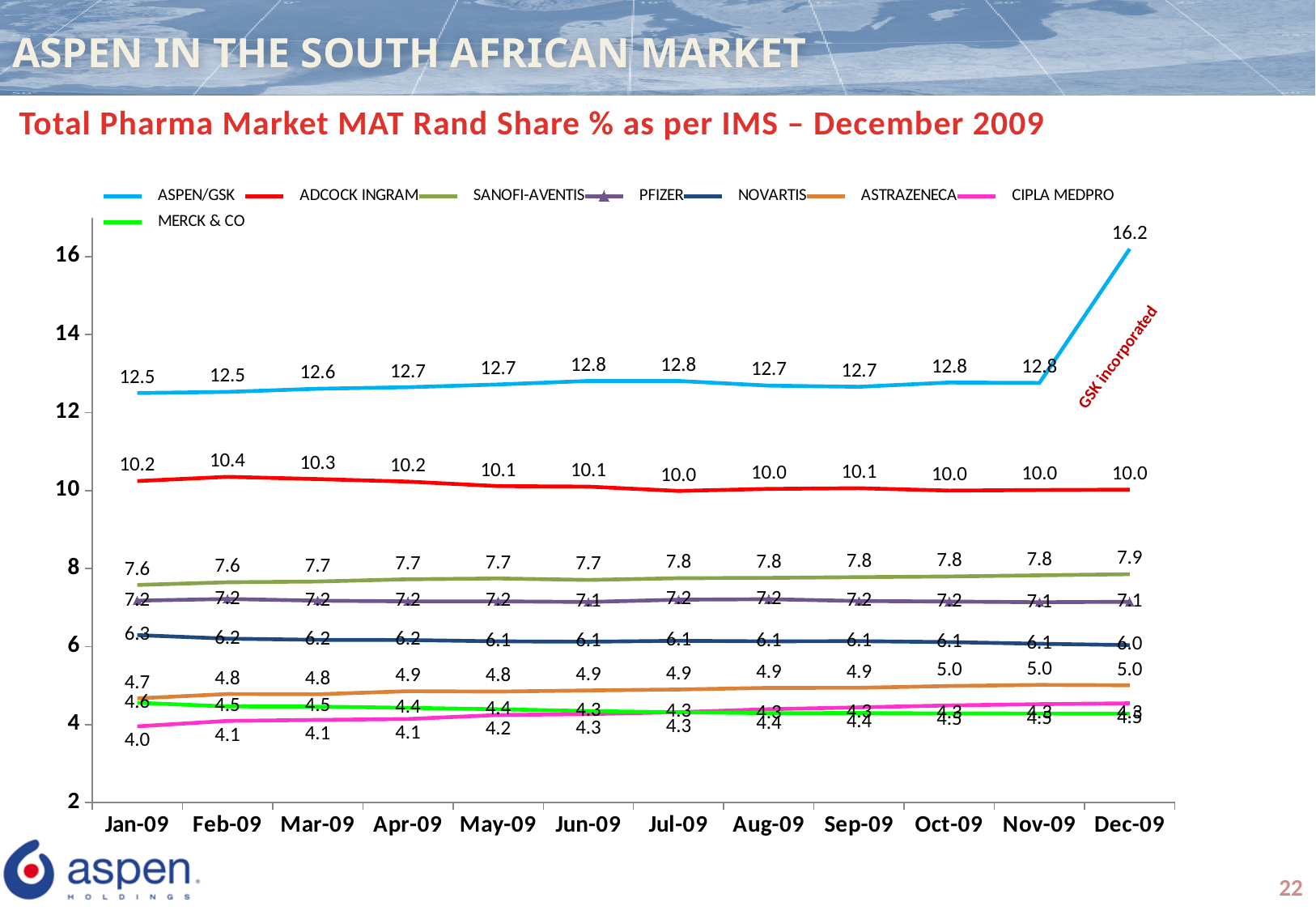
By how much did the ASPEN/GSK value increase from Nov-09 to Dec-09? 3.4 What is the ASPEN/GSK value for Dec-09? 16.2 How many series does the legend list? 8 What is the NOVARTIS value for Jan-09? 6.3 What type of chart is shown on the slide? Line chart How many months are plotted along the x axis? 12 What is the difference between the ASPEN/GSK and ADCOCK INGRAM values in Dec-09? 6.2 Which is larger in Jan-09, ADCOCK INGRAM or SANOFI-AVENTIS? ADCOCK INGRAM In which month does ASPEN/GSK reach its highest value? Dec-09 What is the CIPLA MEDPRO value for Jan-09? 4.0 What annotation is written next to the sharp rise in the ASPEN/GSK line? GSK incorporated What is the ADCOCK INGRAM value for Feb-09? 10.4